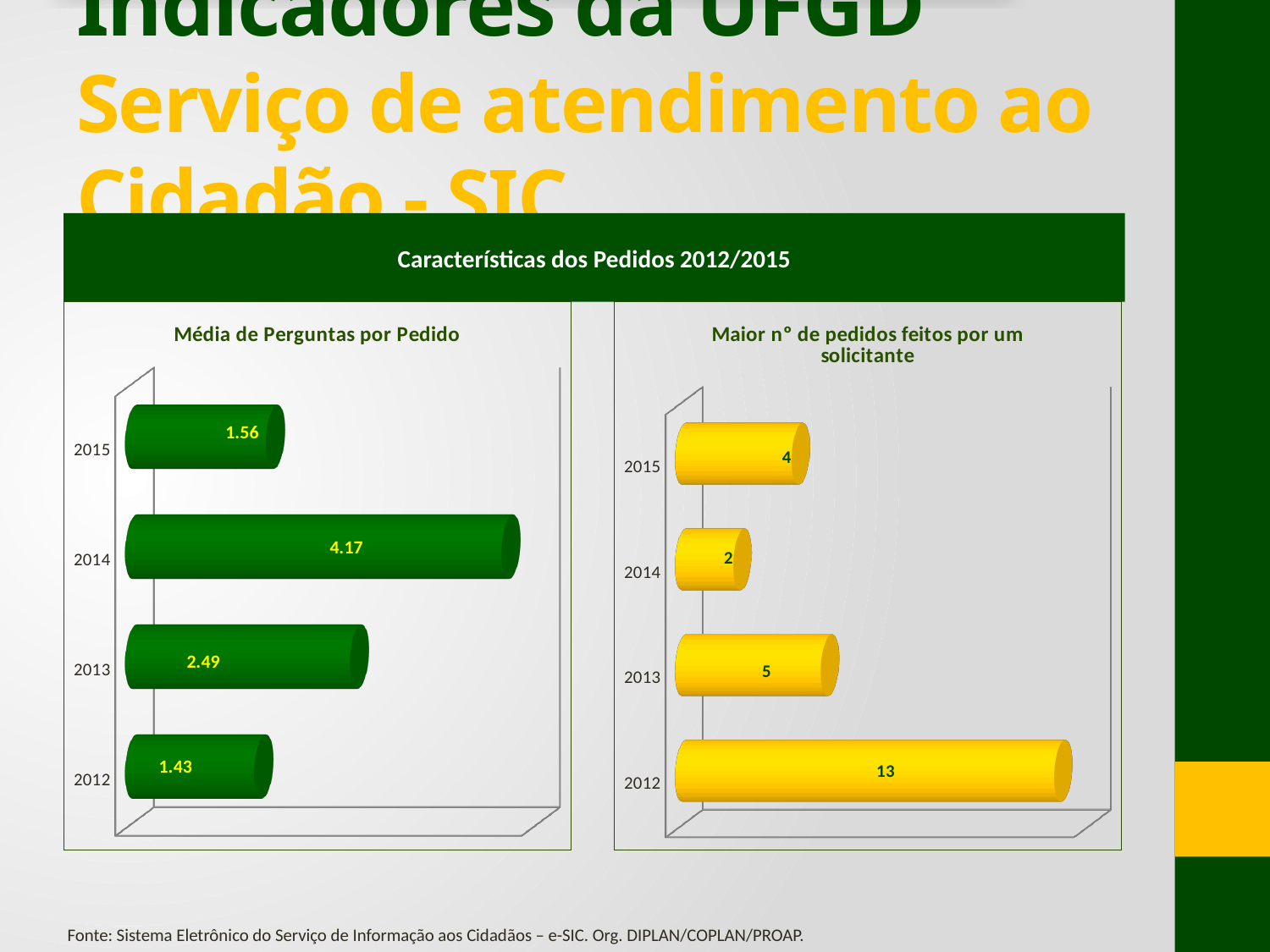
How many years are shown in the 'Média de Perguntas por Pedido' chart? 4 In the 'Maior n° de pedidos feitos por um solicitante' chart, what is the value for 2015? 4 In the 'Maior n° de pedidos feitos por um solicitante' chart, which is larger, the value for 2013 or the value for 2015? 2013 In the 'Média de Perguntas por Pedido' chart, what is the value for 2012? 1.43 In the 'Maior n° de pedidos feitos por um solicitante' chart, what is the difference between the values for 2012 and 2013? 8 In the 'Maior n° de pedidos feitos por um solicitante' chart, which year has the lowest value? 2014 In the 'Média de Perguntas por Pedido' chart, which year has the highest value? 2014 In the 'Maior n° de pedidos feitos por um solicitante' chart, what is the value for 2012? 13 In the 'Média de Perguntas por Pedido' chart, what is the value for 2014? 4.17 What kind of chart is the 'Maior n° de pedidos feitos por um solicitante' chart? bar chart In the 'Média de Perguntas por Pedido' chart, what is the difference between the values for 2014 and 2013? 1.68 In the 'Média de Perguntas por Pedido' chart, which year has the lowest value? 2012